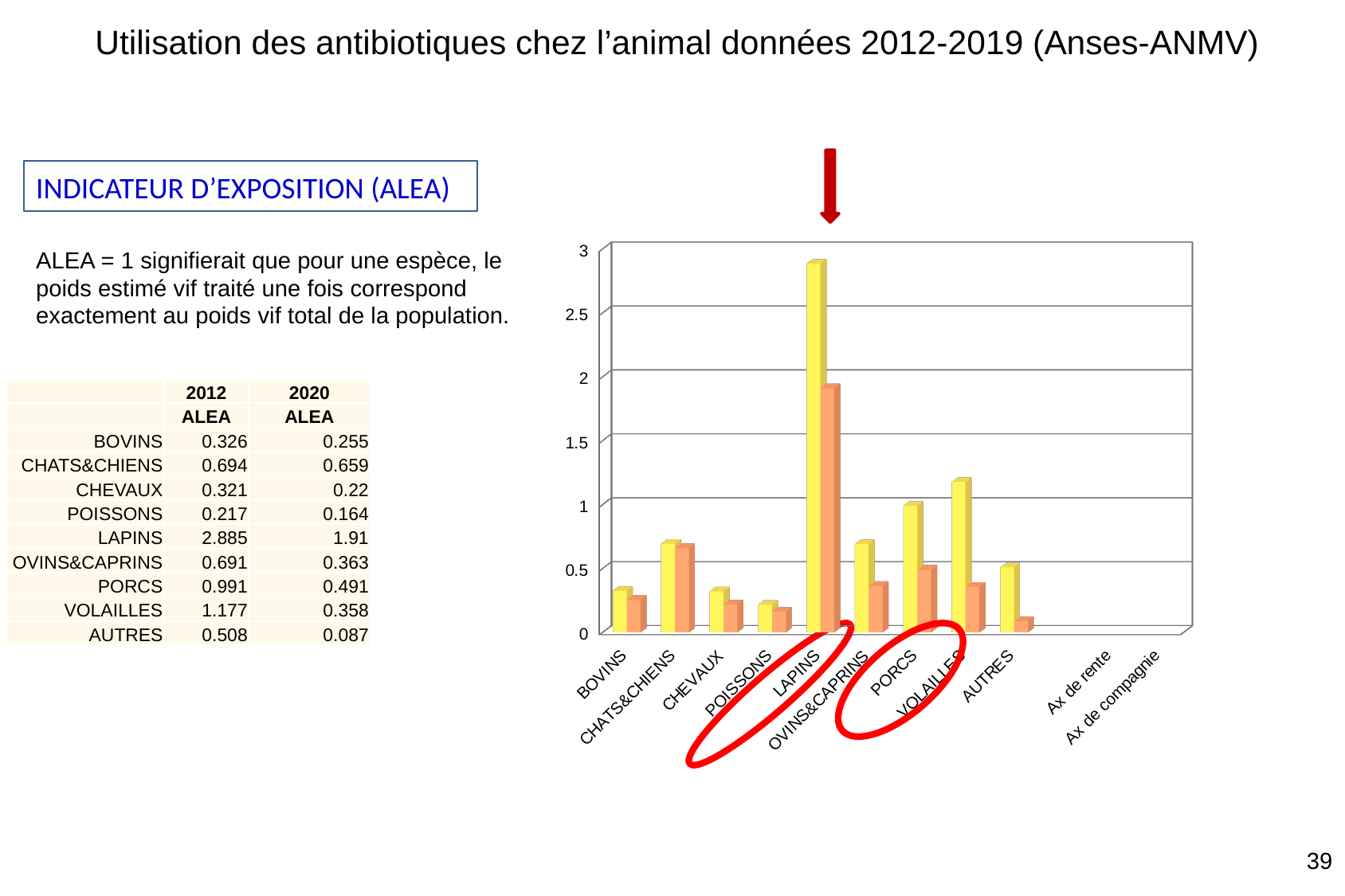
Which is larger, the yellow (2012) bar for PORCS or the yellow (2012) bar for VOLAILLES? VOLAILLES According to the table on the slide, what is the 2012 ALEA value for LAPINS? 2.885 How many categories in the chart have bars plotted? 9 Using the table values, what is the difference between the 2012 and 2020 ALEA for VOLAILLES? 0.819 Is the orange (2020) bar for AUTRES greater or less than 0.5? less Which category has the lowest orange (2020) bar in the chart? AUTRES Is the yellow (2012) bar for LAPINS greater or less than 2.5? greater According to the table on the slide, what is the 2020 ALEA value for PORCS? 0.491 What type of chart is shown on the slide? bar chart Which category has the highest bar in the chart? LAPINS Is the yellow (2012) bar for VOLAILLES greater or less than 1? greater Which category on the x axis does the red arrow above the chart point to? LAPINS